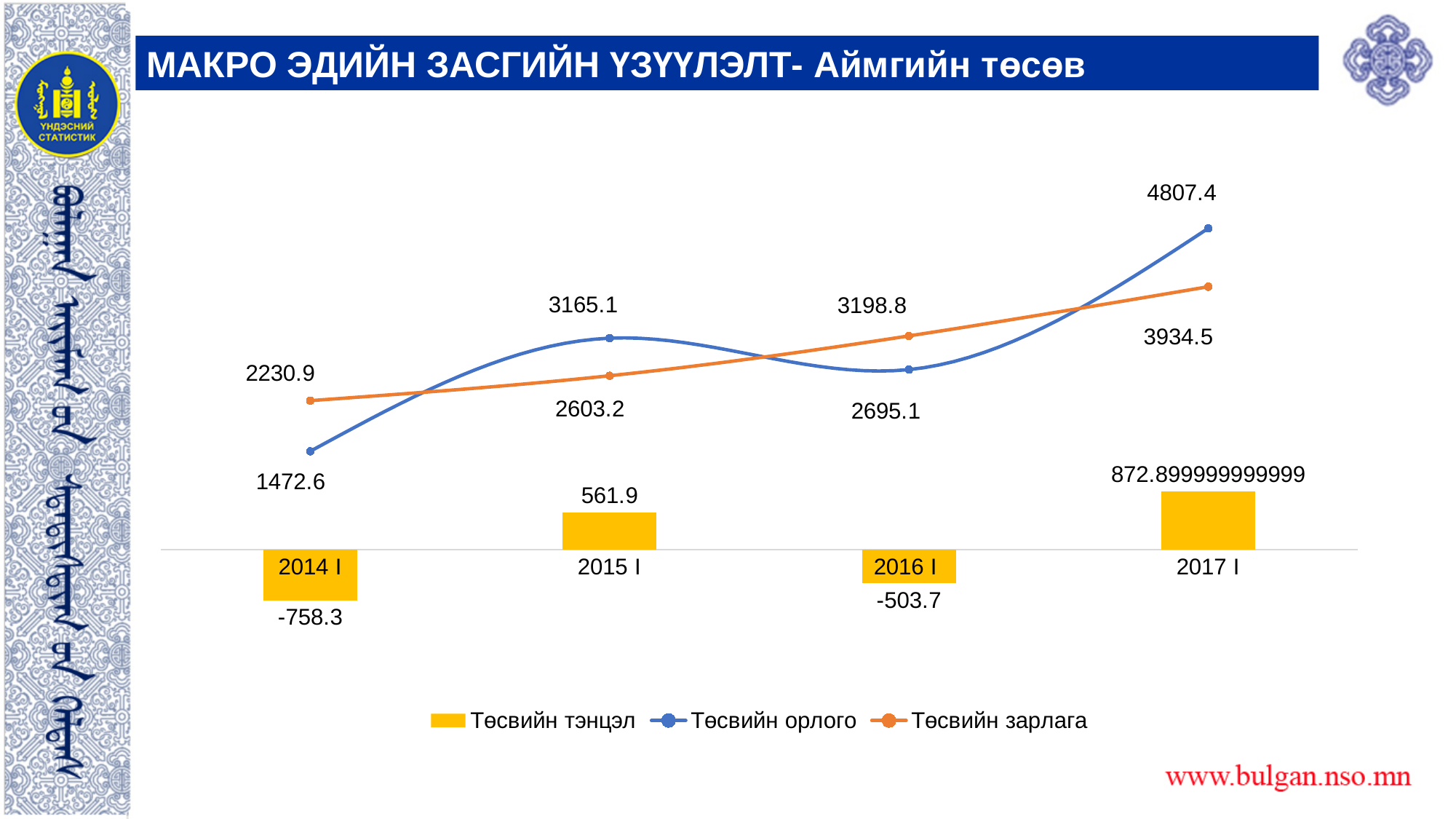
Which series is shown as bars rather than lines? Төсвийн тэнцэл In which period is Төсвийн тэнцэл lowest? 2014 I What is the value of Төсвийн орлого for 2017 I? 4807.4 In which period is Төсвийн орлого highest? 2017 I How many periods are shown on the x axis? 4 What is the difference between Төсвийн орлого and Төсвийн зарлага in 2017 I? 872.9 How many series does the legend list? 3 What is the value of Төсвийн тэнцэл for 2016 I? -503.7 In 2016 I, which is larger: Төсвийн орлого or Төсвийн зарлага? Төсвийн зарлага What is the value of Төсвийн зарлага for 2014 I? 2230.9 Does Төсвийн зарлага rise or fall from 2014 I to 2017 I? rise What is the value of Төсвийн орлого for 2015 I? 3165.1